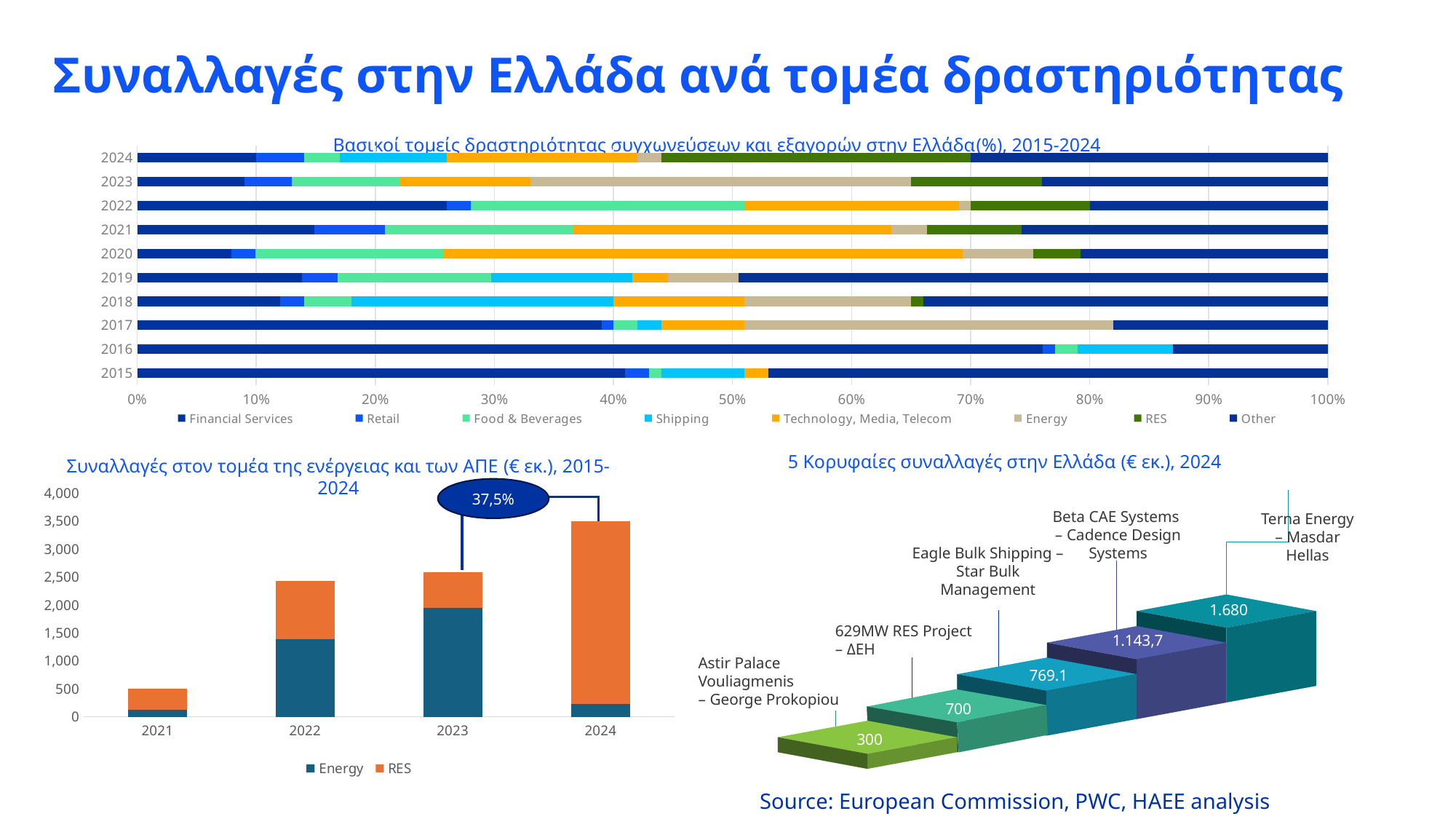
In the top chart (sectors of M&A in Greece, 2015-2024), how many series does the legend list? 8 In the bottom-right chart (5 top deals in Greece, € million, 2024), which deal has the lowest value? Astir Palace Vouliagmenis – George Prokopiou In the bottom-right chart (5 top deals in Greece, € million, 2024), what is the value for Terna Energy – Masdar Hellas? 1.680 In the top chart (sectors of M&A in Greece, 2015-2024), how many years are shown on the vertical axis? 10 In the bottom-left chart (Energy and RES deals, € million), do the total bar heights rise or fall from 2021 to 2024? rise In the bottom-right chart (5 top deals in Greece, € million, 2024), what is the value for Eagle Bulk Shipping – Star Bulk Management? 769.1 In the bottom-right chart (5 top deals in Greece, € million, 2024), what is the difference between the 629MW RES Project – ΔΕΗ deal and the Astir Palace Vouliagmenis – George Prokopiou deal? 400 In the top chart (sectors of M&A in Greece, 2015-2024), is the Financial Services share for 2016 greater or less than 70%? greater What kind of chart is the top chart titled 'Βασικοί τομείς δραστηριότητας συγχωνεύσεων και εξαγορών στην Ελλάδα(%), 2015-2024'? Stacked bar chart In the bottom-left chart (Energy and RES deals, € million), is the total bar for 2024 greater or less than 3,000? greater In the top chart (sectors of M&A in Greece, 2015-2024), is the Financial Services share for 2020 greater or less than 10%? less In the bottom-left chart (Energy and RES deals, € million, 2015-2024), how many series does the legend list? 2